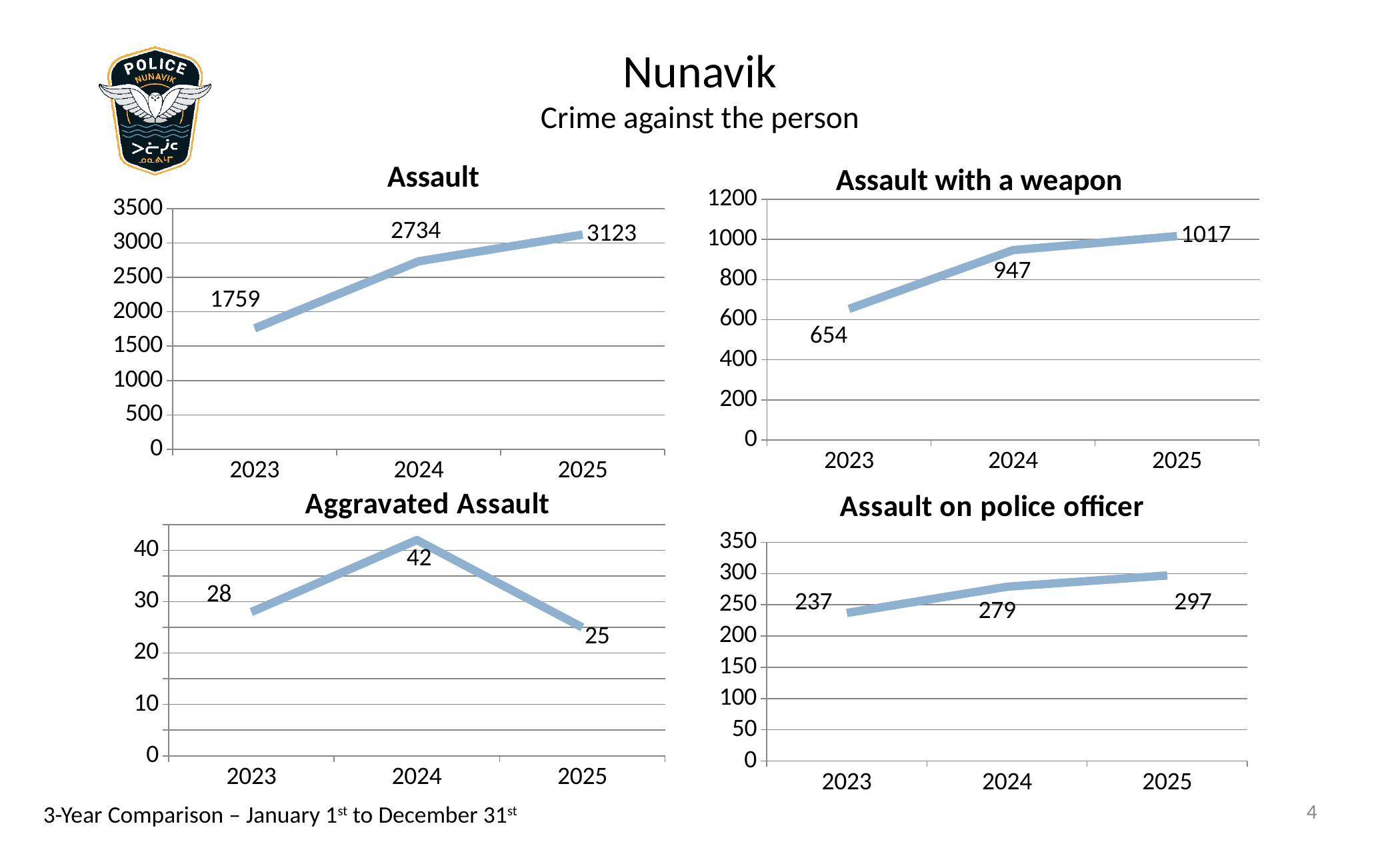
In the Aggravated Assault chart, is the value for 2023 or 2025 larger? 2023 What is the title of the chart in the bottom-left of the slide? Aggravated Assault How many years are plotted in the Assault on police officer chart? 3 In the Assault with a weapon chart, what is the value for 2023? 654 In the Assault with a weapon chart, is the value for 2025 greater or less than 1000? greater In the Assault chart, what is the difference between the 2025 and 2023 values? 1364 In the Assault on police officer chart, what is the difference between the 2024 and 2023 values? 42 What kind of chart is the Aggravated Assault chart? line chart In the Assault with a weapon chart, do the values rise or fall from 2023 to 2025? rise In the Assault on police officer chart, which year has the lowest value? 2023 In the Assault chart, what is the value for 2024? 2734 In the Aggravated Assault chart, which year has the highest value? 2024